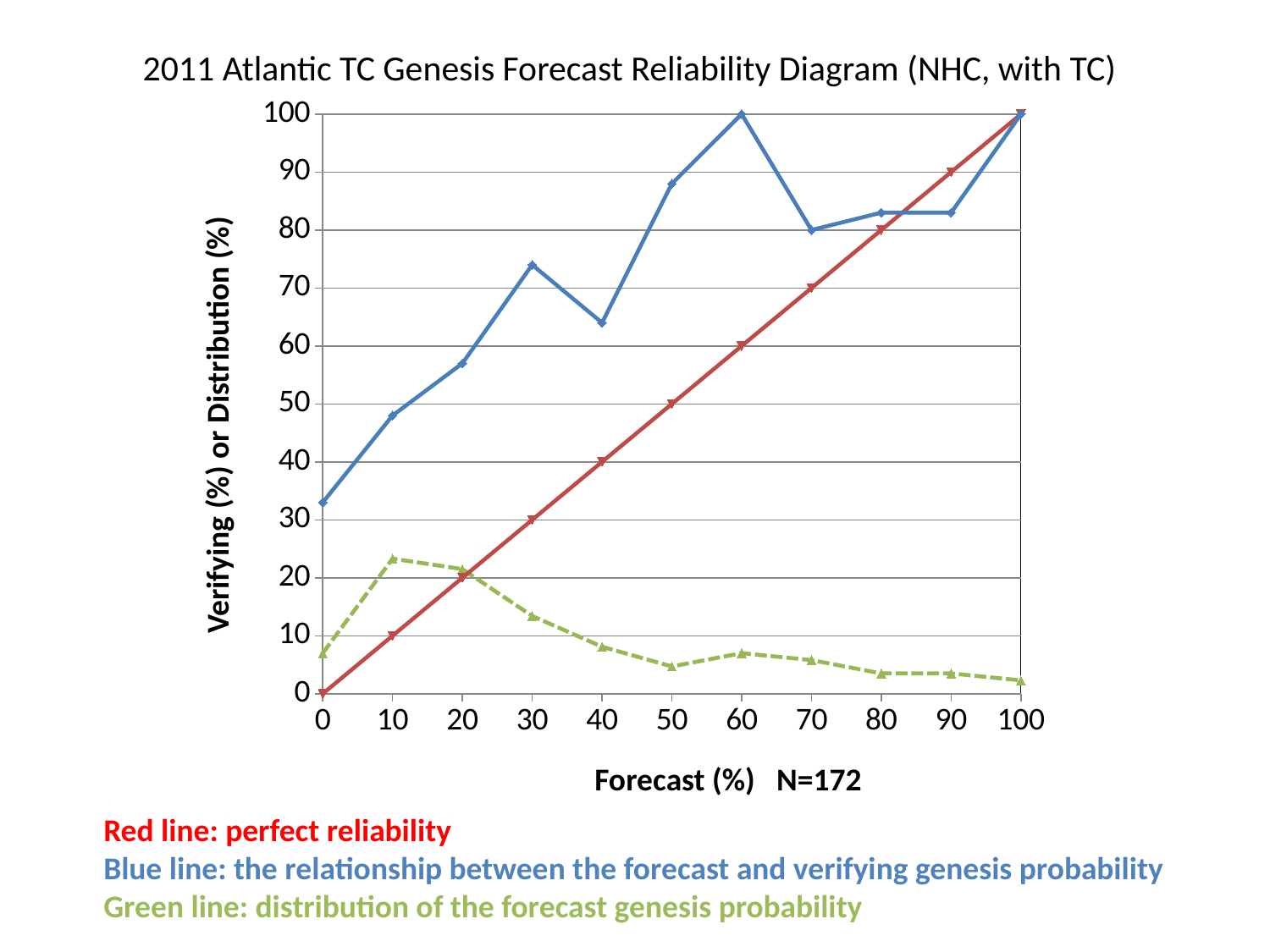
How many forecast (%) points are marked along the x axis? 11 Is the value of the blue line at a forecast of 0% greater or less than 30? greater At which forecast value does the green line reach its highest point? 10 How many lines are plotted on the chart? 3 Is the value of the green line at a forecast of 10% greater or less than 20? greater What kind of chart is shown on the slide? line chart Does the red line rise or fall as the forecast increases from 0 to 100? rises At which forecast value is the blue line at its lowest? 0 At a forecast of 50%, which is larger: the blue line or the red line? blue line What is the value of the blue line at a forecast of 60%? 100 Is the value of the blue line at a forecast of 40% greater or less than 70? less What is the value of the red perfect reliability line at a forecast of 50%? 50